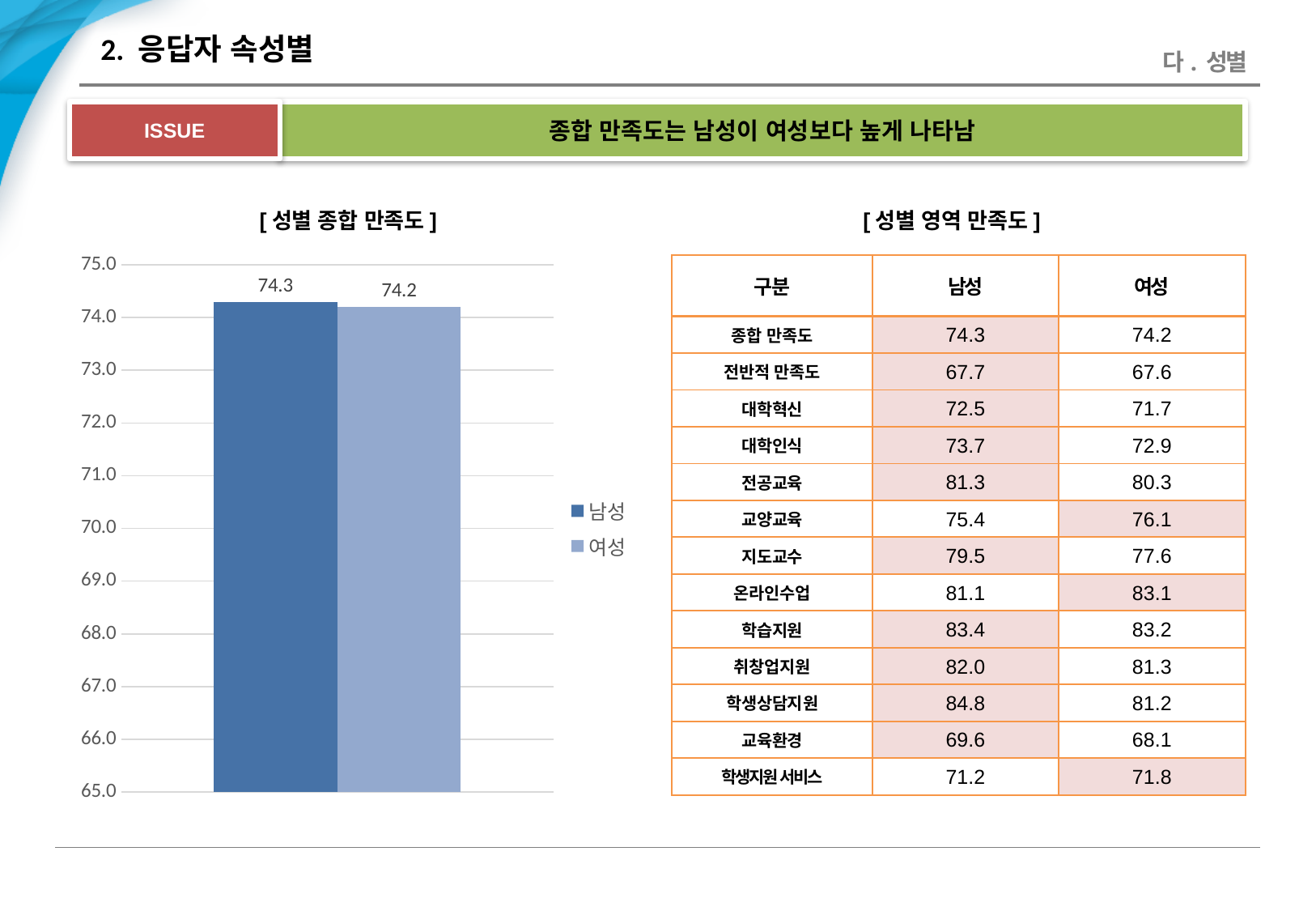
In the [ 성별 종합 만족도 ] chart, is the value for 여성 greater or less than 75.0? less In the [ 성별 종합 만족도 ] chart, what is the difference between the 남성 and 여성 values? 0.1 In the [ 성별 종합 만족도 ] chart, is the value for 남성 greater or less than 74.0? greater How many series does the legend of the [ 성별 종합 만족도 ] chart list? 2 What are the legend entries of the [ 성별 종합 만족도 ] chart? 남성, 여성 In the [ 성별 종합 만족도 ] chart, what is the value for 여성? 74.2 In the [ 성별 종합 만족도 ] chart, what is the value for 남성? 74.3 In the [ 성별 종합 만족도 ] chart, which group has the higher value, 남성 or 여성? 남성 What is the lowest value shown on the vertical axis of the [ 성별 종합 만족도 ] chart? 65.0 How many bars are plotted in the [ 성별 종합 만족도 ] chart? 2 In the [ 성별 종합 만족도 ] chart, which group has the lowest value? 여성 What kind of chart is shown under the title [ 성별 종합 만족도 ]? bar chart